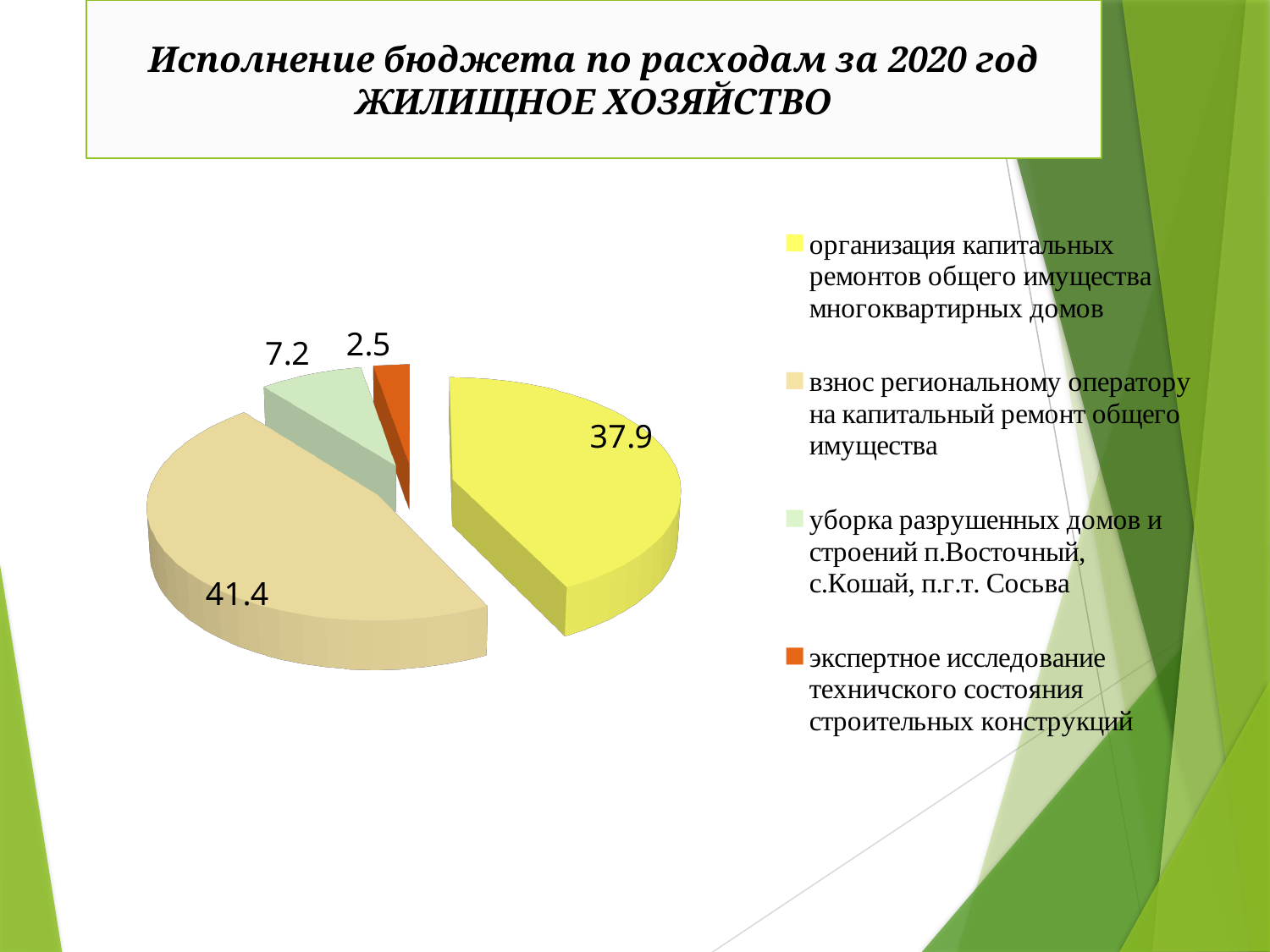
What type of chart is shown on the slide? Pie chart What is the difference between the values for "взнос региональному оператору на капитальный ремонт общего имущества" and "организация капитальных ремонтов общего имущества многоквартирных домов"? 3.5 What is the value for "уборка разрушенных домов и строений п.Восточный, с.Кошай, п.г.т. Сосьва"? 7.2 What colour is the slice for "экспертное исследование техничского состояния строительных конструкций"? Orange Which is larger: the value for "уборка разрушенных домов и строений" or the value for "экспертное исследование техничского состояния строительных конструкций"? уборка разрушенных домов и строений Which category has the largest slice of the pie? взнос региональному оператору на капитальный ремонт общего имущества What is the value for "экспертное исследование техничского состояния строительных конструкций"? 2.5 What is the value for "организация капитальных ремонтов общего имущества многоквартирных домов"? 37.9 Which category has the smallest slice of the pie? экспертное исследование техничского состояния строительных конструкций How many slices does the pie chart have? 4 What is the difference between the values for "уборка разрушенных домов и строений" and "экспертное исследование техничского состояния строительных конструкций"? 4.7 What is the value for "взнос региональному оператору на капитальный ремонт общего имущества"? 41.4